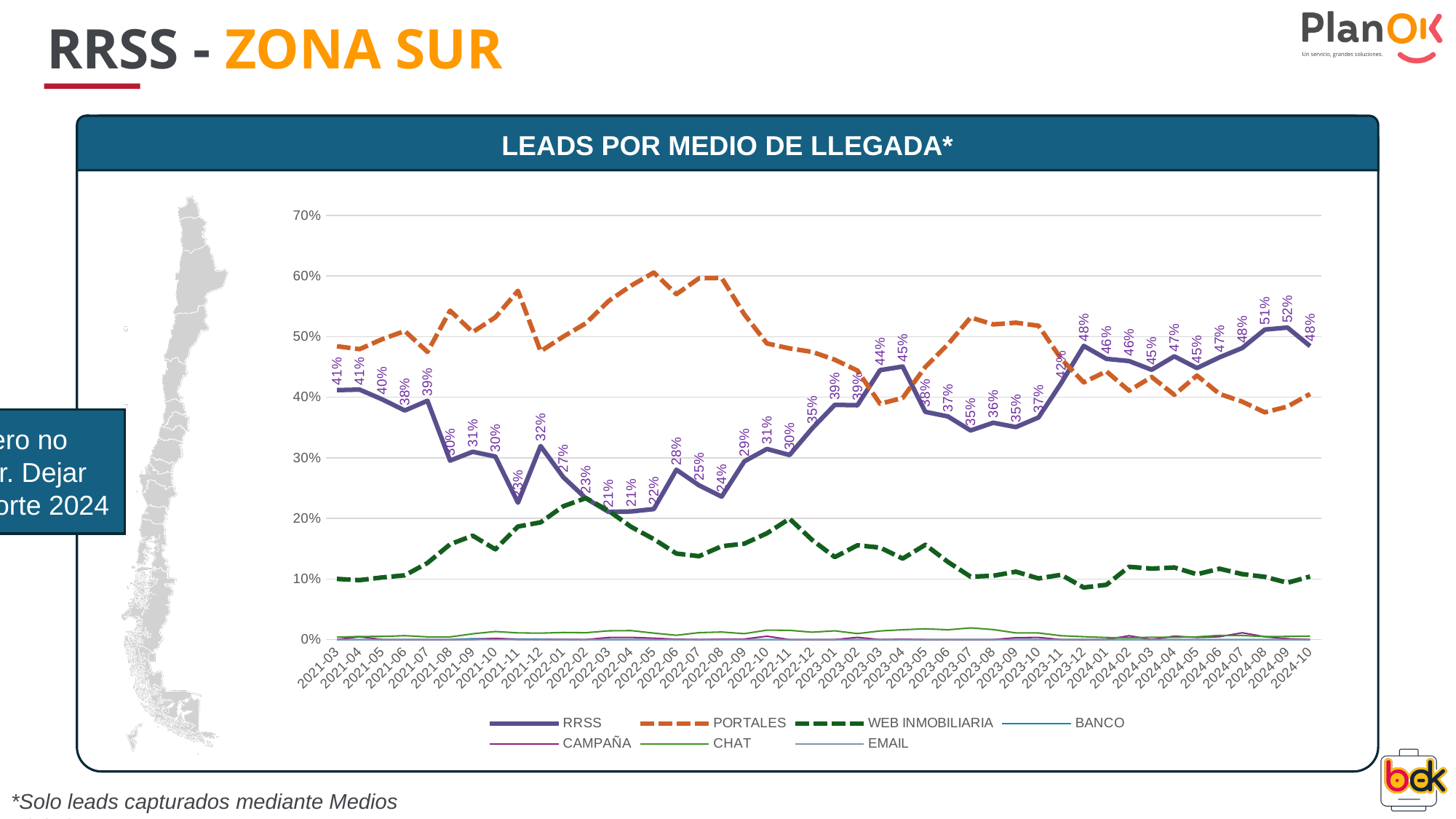
What is the RRSS value for 2023-04? 45% What is the difference between the RRSS value in 2024-09 and in 2021-03? 11 percentage points How many series does the legend of the chart list? 7 Does the RRSS series rise or fall between 2021-03 and 2021-11? Fall What is the lowest value shown for the RRSS series? 21% What type of chart is shown under the title LEADS POR MEDIO DE LLEGADA*? Line chart Which series is drawn with an orange dashed line? PORTALES In 2024-10, which series has the larger value, RRSS or PORTALES? RRSS What is the RRSS value for 2021-03? 41% In which month does the RRSS series reach its highest value? 2024-09 What is the RRSS value for 2024-10? 48% Is the PORTALES value for 2023-07 greater or less than 50%? greater